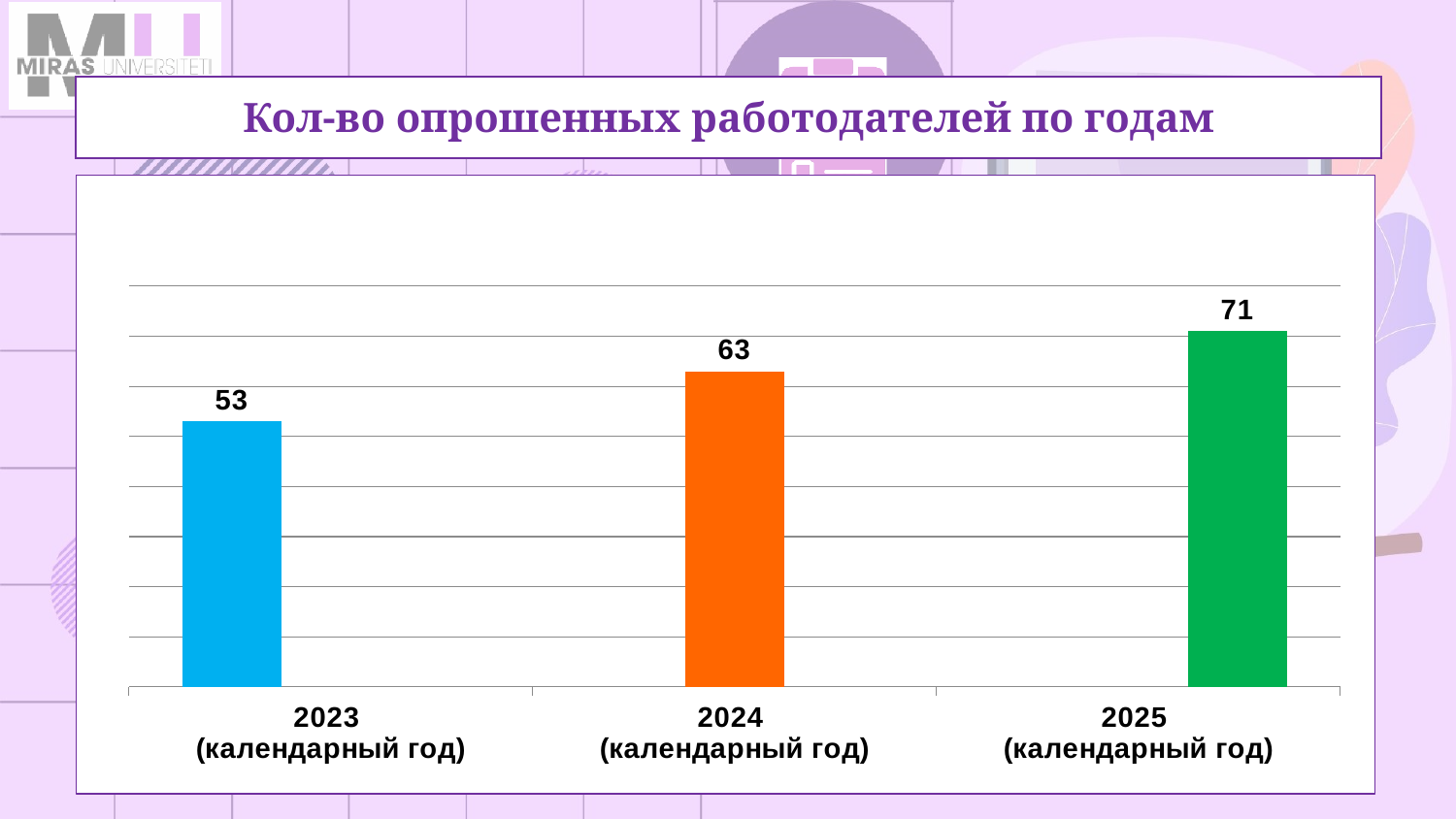
Which is larger, the value for 2024 or the value for 2025? 2025 (календарный год) Do the values rise or fall from 2023 to 2025? Rise What is the difference between the values for 2024 and 2023? 10 What kind of chart is shown on the slide? Bar chart What is the title of the chart? Кол-во опрошенных работодателей по годам What is the value for 2025 (календарный год)? 71 What is the value for 2024 (календарный год)? 63 What is the difference between the values for 2025 and 2023? 18 What is the value for 2023 (календарный год)? 53 Which year has the lowest number of surveyed employers? 2023 (календарный год) Which year has the highest number of surveyed employers? 2025 (календарный год) How many categories are shown on the chart? 3